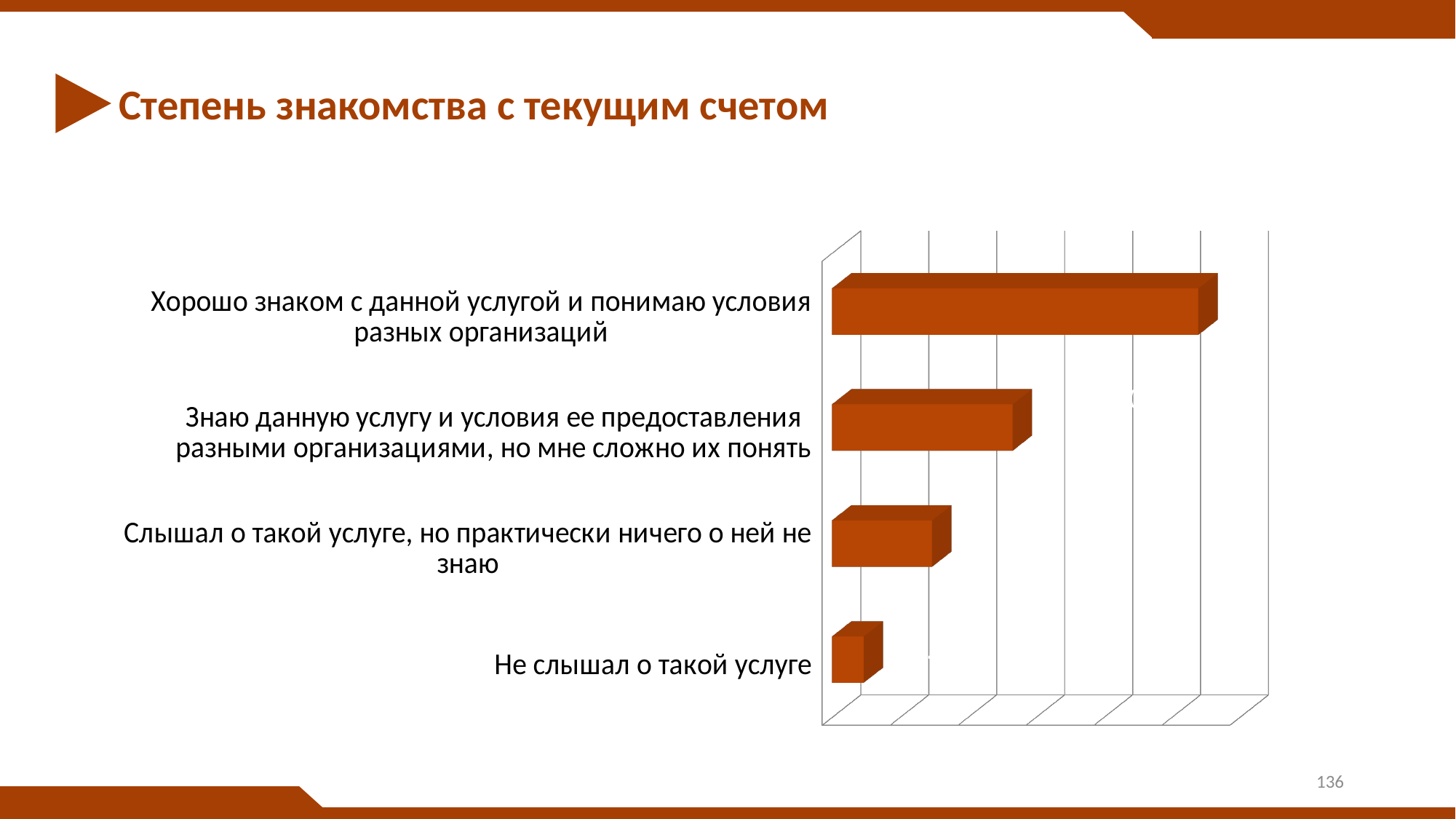
What colour are the bars in the chart? orange-brown Which category has the shortest bar? Не слышал о такой услуге What is the title of the slide with the chart? Степень знакомства с текущим счетом Which bar is longer: "Знаю данную услугу и условия ее предоставления разными организациями, но мне сложно их понять" or "Слышал о такой услуге, но практически ничего о ней не знаю"? Знаю данную услугу и условия ее предоставления разными организациями, но мне сложно их понять Which category has the longest bar? Хорошо знаком с данной услугой и понимаю условия разных организаций How many categories are shown in the chart? 4 What kind of chart is shown on the slide? bar chart Which bar is longer: "Слышал о такой услуге, но практически ничего о ней не знаю" or "Не слышал о такой услуге"? Слышал о такой услуге, но практически ничего о ней не знаю Which bar is longer: "Знаю данную услугу и условия ее предоставления разными организациями, но мне сложно их понять" or "Хорошо знаком с данной услугой и понимаю условия разных организаций"? Хорошо знаком с данной услугой и понимаю условия разных организаций Going from the top category to the bottom category, do the bars get longer or shorter? shorter Which category is listed at the bottom of the chart? Не слышал о такой услуге